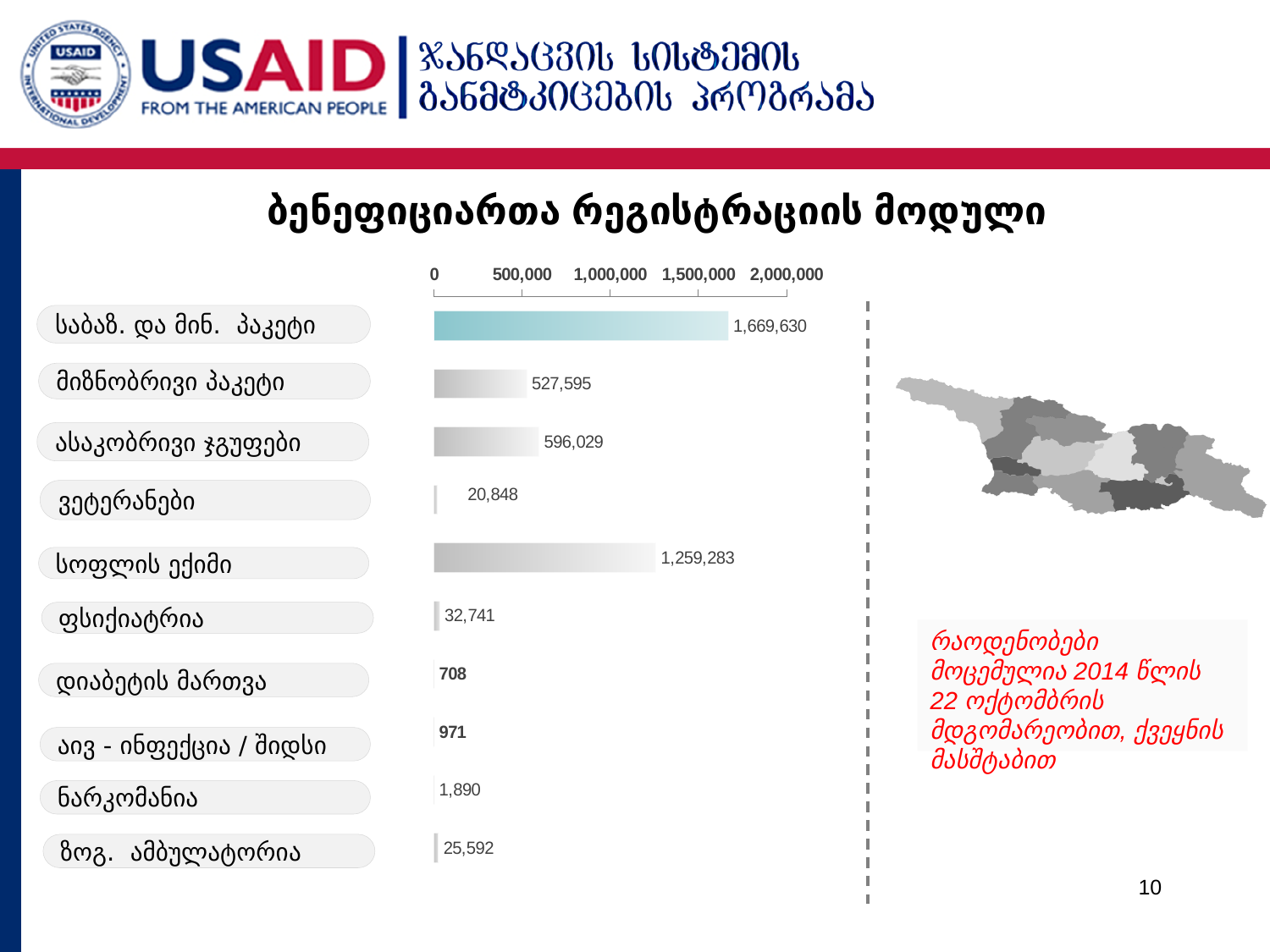
What kind of chart is shown on the slide? bar chart Is the value for სოფლის ექიმი greater or less than 1,000,000? greater What is the difference between the values for ასაკობრივი ჯგუფები and მიზნობრივი პაკეტი? 68,434 Which category has the lowest value? დიაბეტის მართვა What is the value for სოფლის ექიმი? 1,259,283 What is the value for ვეტერანები? 20,848 How many categories are shown in the chart? 10 What is the value for დიაბეტის მართვა? 708 Which is larger, the value for ფსიქიატრია or the value for ზოგ. ამბულატორია? ფსიქიატრია What is the title of the slide containing the chart? ბენეფიციართა რეგისტრაციის მოდული Which category has the highest value? საბაზ. და მინ. პაკეტი What is the value for საბაზ. და მინ. პაკეტი? 1,669,630